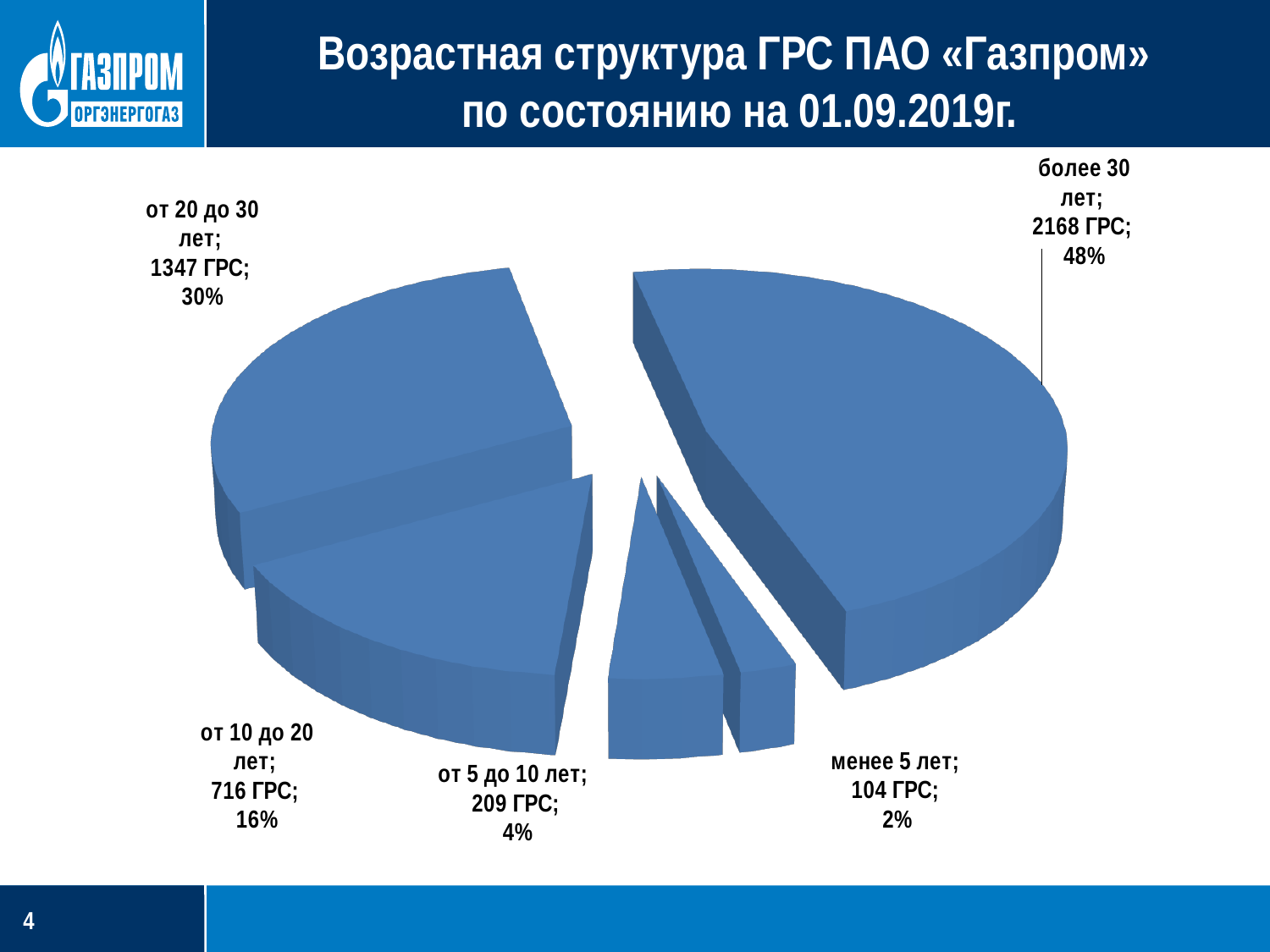
What share of the pie does the 'от 20 до 30 лет' slice represent? 30% What percentage is shown for the 'менее 5 лет' slice? 2% What is the difference in ГРС count between 'более 30 лет' and 'от 20 до 30 лет'? 821 What kind of chart is shown on the slide? pie chart Which category has the largest number of ГРС? более 30 лет How many slices does the pie chart have? 5 Which category has more ГРС: 'от 5 до 10 лет' or 'от 10 до 20 лет'? от 10 до 20 лет How many ГРС are in the 'более 30 лет' category? 2168 ГРС What is the total number of ГРС across all five categories? 4544 How many ГРС are in the 'от 10 до 20 лет' category? 716 ГРС What is the title of the chart on the slide? Возрастная структура ГРС ПАО «Газпром» по состоянию на 01.09.2019г. Which category has the smallest number of ГРС? менее 5 лет